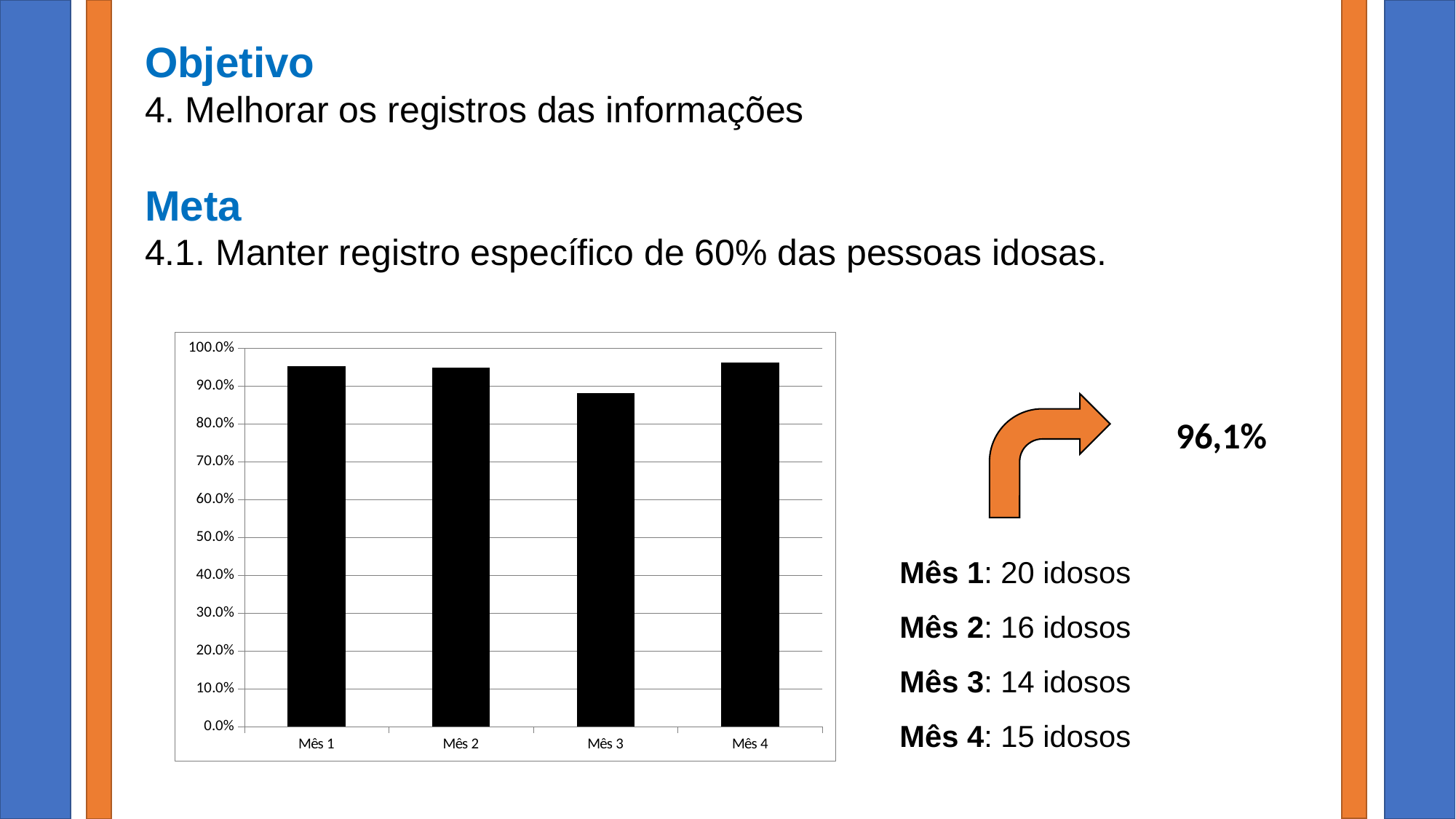
Which month has the lowest bar on the chart? Mês 3 Is the value for Mês 3 greater or less than 80.0%? greater Is the value for Mês 2 greater or less than 60.0%? greater How many categories (months) are plotted on the chart? 4 Which is larger, the value for Mês 4 or the value for Mês 3? Mês 4 Is the value for Mês 4 greater or less than 90.0%? greater What kind of chart is shown on the slide? bar chart Which is larger, the value for Mês 1 or the value for Mês 3? Mês 1 What colour are the bars in the chart? black What is the highest value shown on the chart's vertical axis? 100.0%